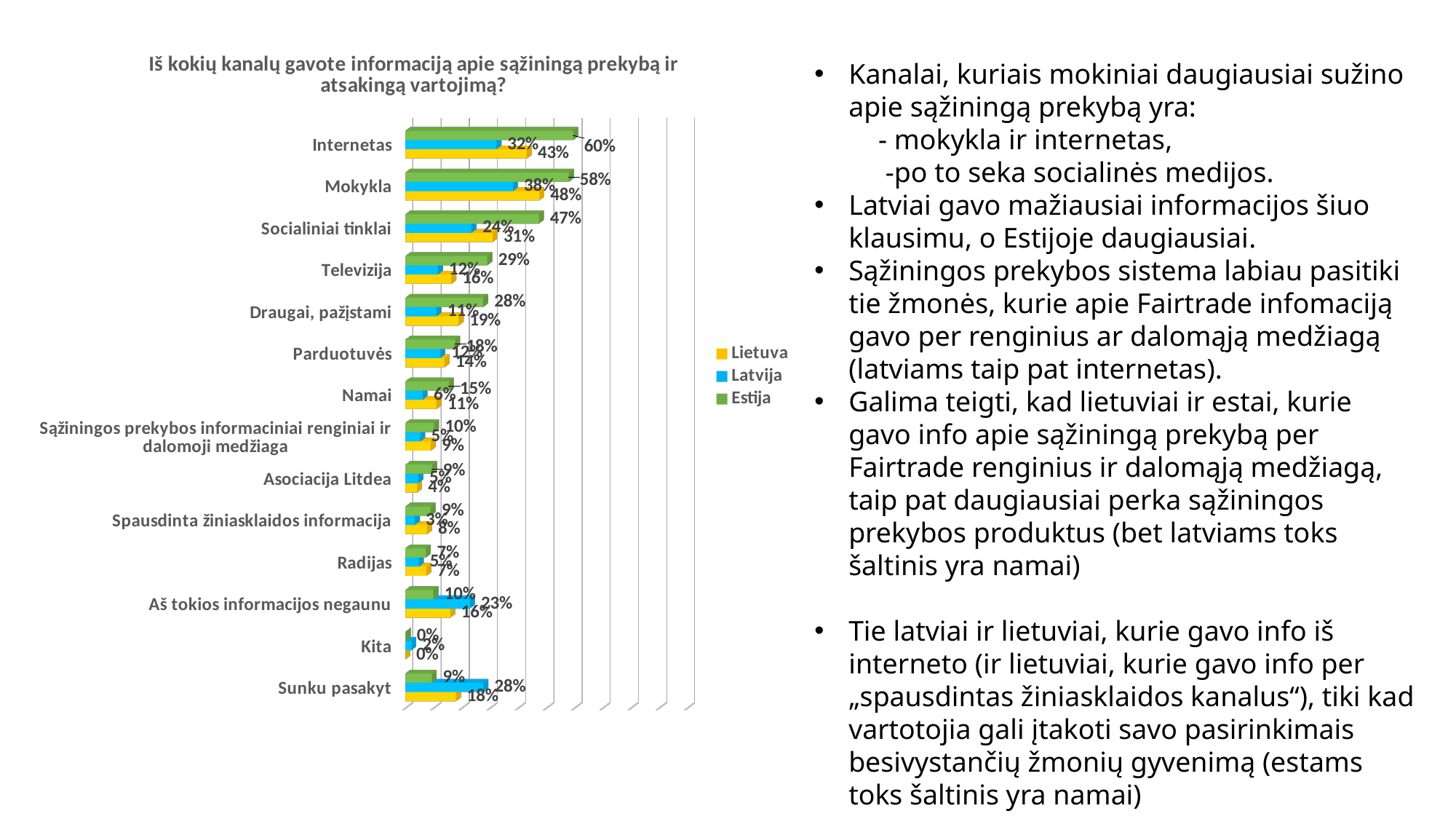
What is the value for Latvija in the Socialiniai tinklai category? 24% What kind of chart is shown on the slide? bar chart Which series is shown in green in the legend? Estija Which category has the highest value for Latvija? Mokykla Which category has the highest value for Estija? Internetas What is the value for Lietuva in the Mokykla category? 48% What is the value for Estija in the Internetas category? 60% How many series does the legend list? 3 How many categories are shown on the chart? 14 What is the value for Latvija in the Sunku pasakyt category? 28% What is the difference between the Estija and Latvija values for Internetas? 28% Which is larger for Televizija: the value for Lietuva or the value for Estija? Estija